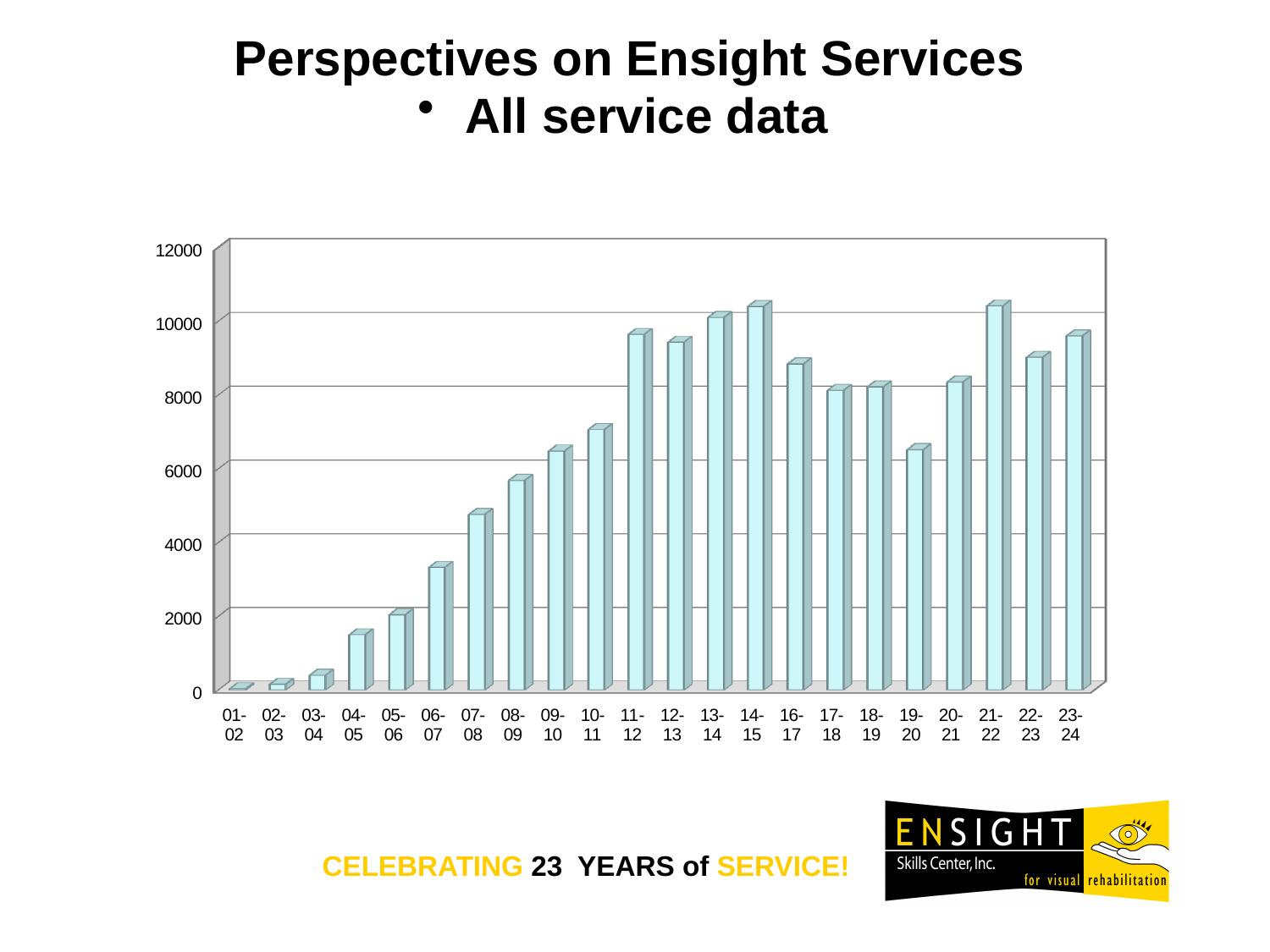
How many categories (year ranges) are shown on the x axis of the chart? 22 Is the value for 11-12 greater or less than 8000? greater Is the value for 16-17 greater or less than 8000? greater Which is larger, the value for 11-12 or the value for 19-20? 11-12 Which category has the lowest value in the chart? 01-02 What is the title of the slide containing the chart? Perspectives on Ensight Services Which is larger, the value for 05-06 or the value for 08-09? 08-09 Do the values rise or fall from 01-02 to 11-12? rise What kind of chart is shown on the slide? bar chart Is the value for 19-20 greater or less than 8000? less